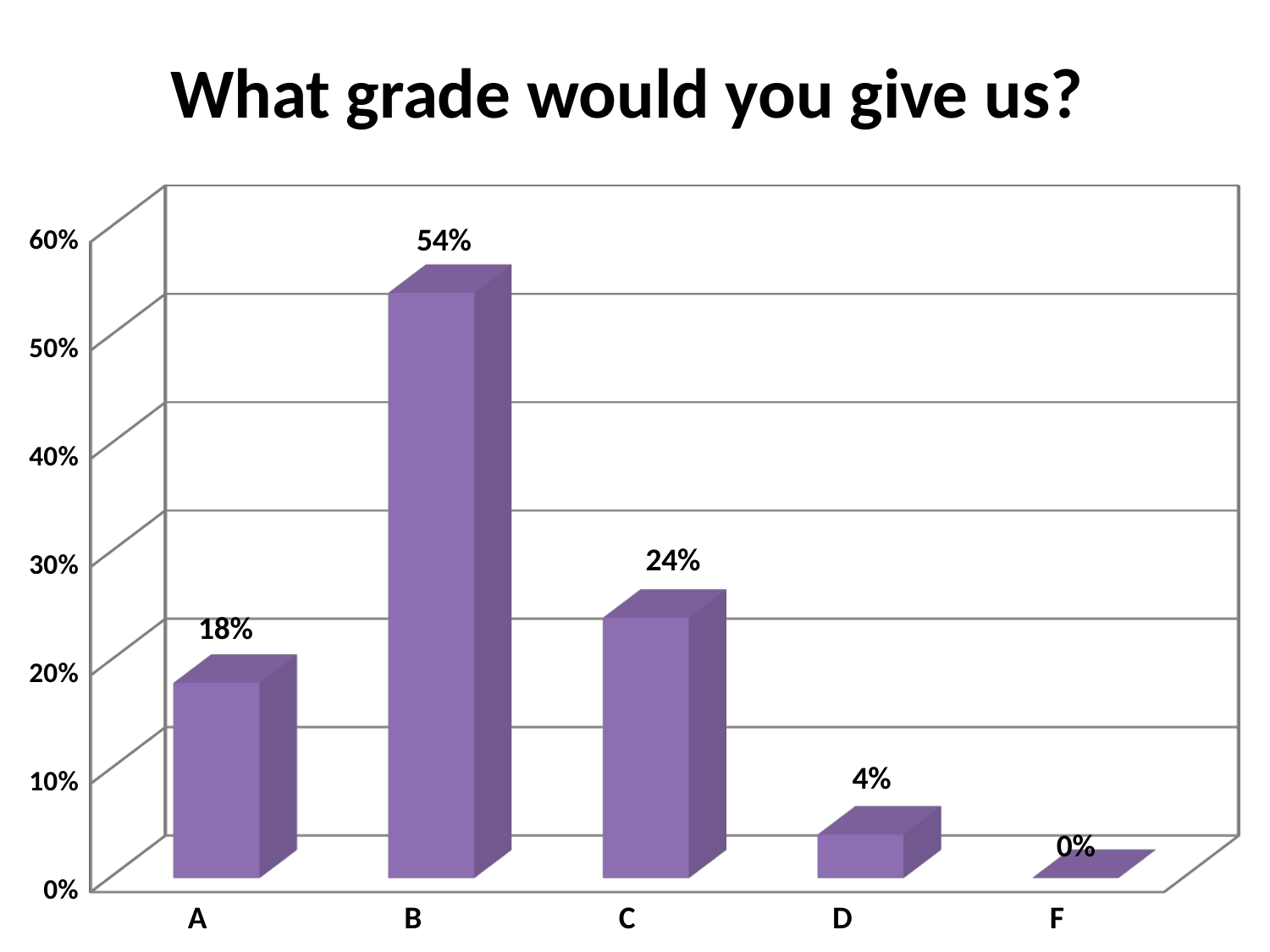
What is the difference in percentage points between grade B and grade C? 30% What kind of chart is shown on the slide? Bar chart What percentage of respondents gave a grade of D? 4% What is the title of the chart? What grade would you give us? How many grade categories are shown on the x axis? 5 Which grade received the lowest percentage of responses? F What percentage of respondents gave a grade of A? 18% Which grade has a larger share of responses, A or C? C Is the value for grade B greater or less than 50%? greater What percentage of respondents gave a grade of B? 54% Which grade received the highest percentage of responses? B What percentage of respondents gave a grade of F? 0%